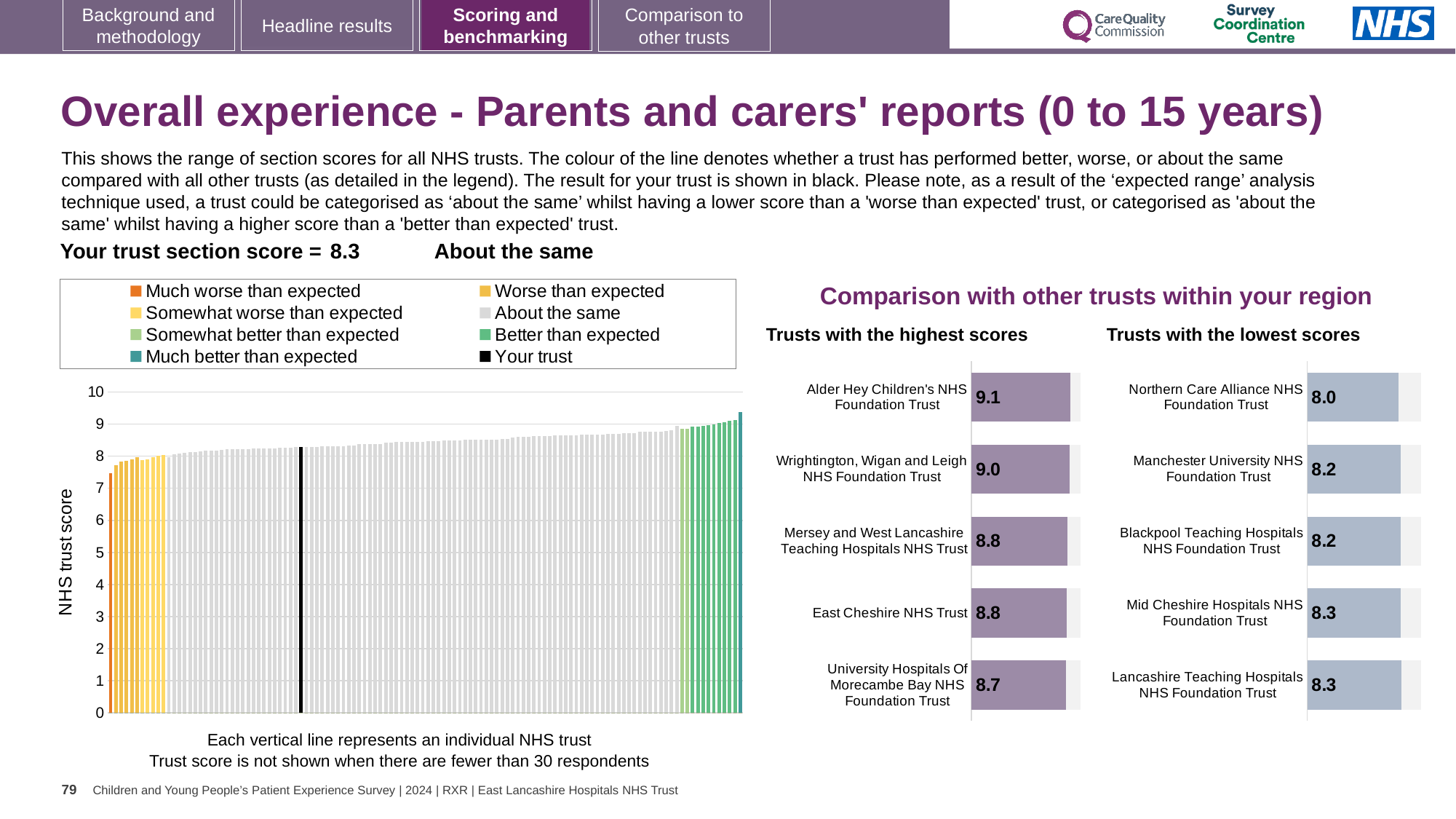
In the 'Trusts with the highest scores' chart, what is the score for University Hospitals Of Morecambe Bay NHS Foundation Trust? 8.7 What is the y-axis label of the large chart on the left? NHS trust score In the 'Trusts with the lowest scores' chart, what is the score for Mid Cheshire Hospitals NHS Foundation Trust? 8.3 In the 'Trusts with the lowest scores' chart, what is the score for Northern Care Alliance NHS Foundation Trust? 8.0 In the 'Trusts with the lowest scores' chart, which has the larger score: Manchester University NHS Foundation Trust or Lancashire Teaching Hospitals NHS Foundation Trust? Lancashire Teaching Hospitals NHS Foundation Trust How many trusts are shown in the 'Trusts with the highest scores' chart? 5 In the large chart on the left showing all NHS trusts, is the value of the lowest (orange) bar greater or less than 8? less In the 'Trusts with the highest scores' chart, what is the difference between the scores of Alder Hey Children's NHS Foundation Trust and University Hospitals Of Morecambe Bay NHS Foundation Trust? 0.4 In the 'Trusts with the highest scores' chart, what is the score for Alder Hey Children's NHS Foundation Trust? 9.1 In the 'Trusts with the highest scores' chart, which trust has the highest score? Alder Hey Children's NHS Foundation Trust In the 'Trusts with the lowest scores' chart, which trust has the lowest score? Northern Care Alliance NHS Foundation Trust How many entries does the legend of the large chart on the left list? 8